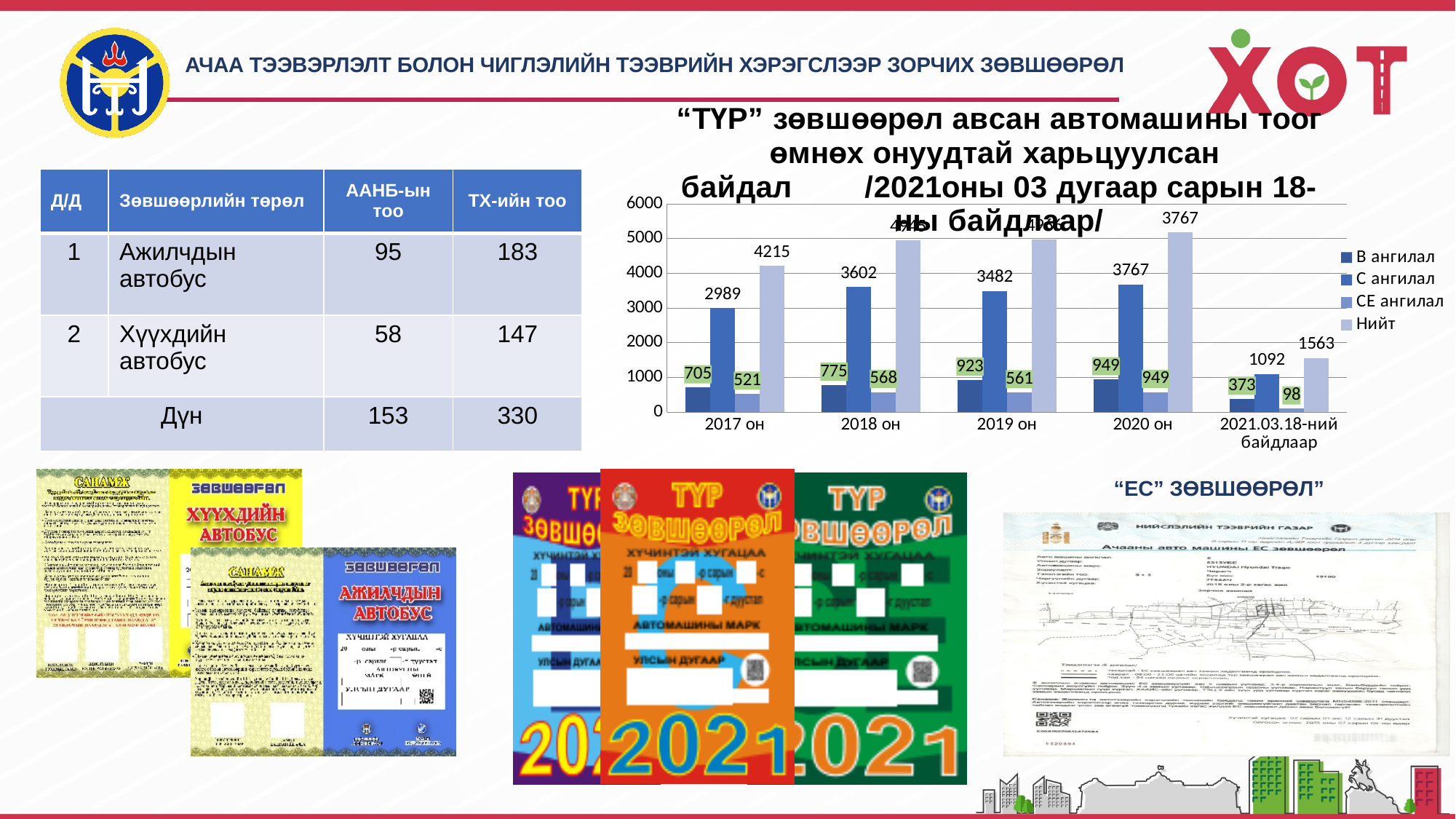
Is the С ангилал value for 2021.03.18-ний байдлаар greater or less than 1000? greater Which category has the lowest Нийт value? 2021.03.18-ний байдлаар What is the difference between the С ангилал values for 2018 он and 2017 он? 613 How many series does the chart legend list? 4 What is the value of В ангилал for 2019 он? 923 What is the Нийт value for 2017 он? 4215 What kind of chart is shown on the slide? bar chart What is the Нийт value for 2021.03.18-ний байдлаар? 1563 What is the value of С ангилал for 2017 он? 2989 What is the value of СЕ ангилал for 2018 он? 568 How many year categories are shown on the x axis of the chart? 5 Which year has the larger В ангилал value, 2017 он or 2020 он? 2020 он